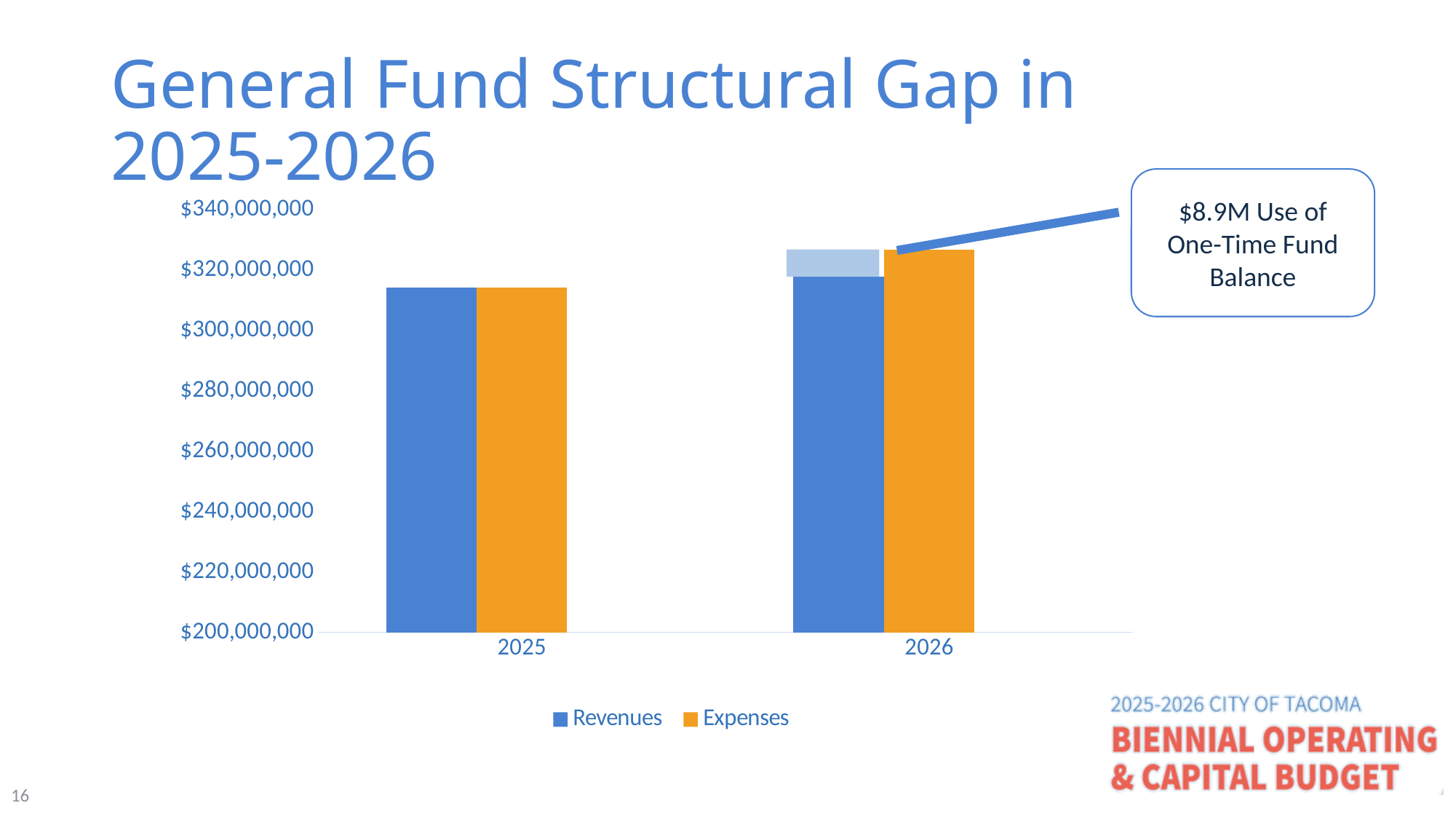
Is the value for Expenses in 2025 greater or less than $320,000,000? less Is the value for Expenses in 2026 greater or less than $320,000,000? greater What is the title of the slide containing the chart? General Fund Structural Gap in 2025-2026 What are the two series listed in the chart legend? Revenues and Expenses In 2026, which is larger, Revenues or Expenses? Expenses Is the value for Revenues in 2026 greater or less than $340,000,000? less What kind of chart is shown on the slide? bar chart How many years are shown on the x axis of the chart? 2 Do Expenses rise or fall from 2025 to 2026? rise How many series does the chart legend list? 2 Which year has the higher Expenses value? 2026